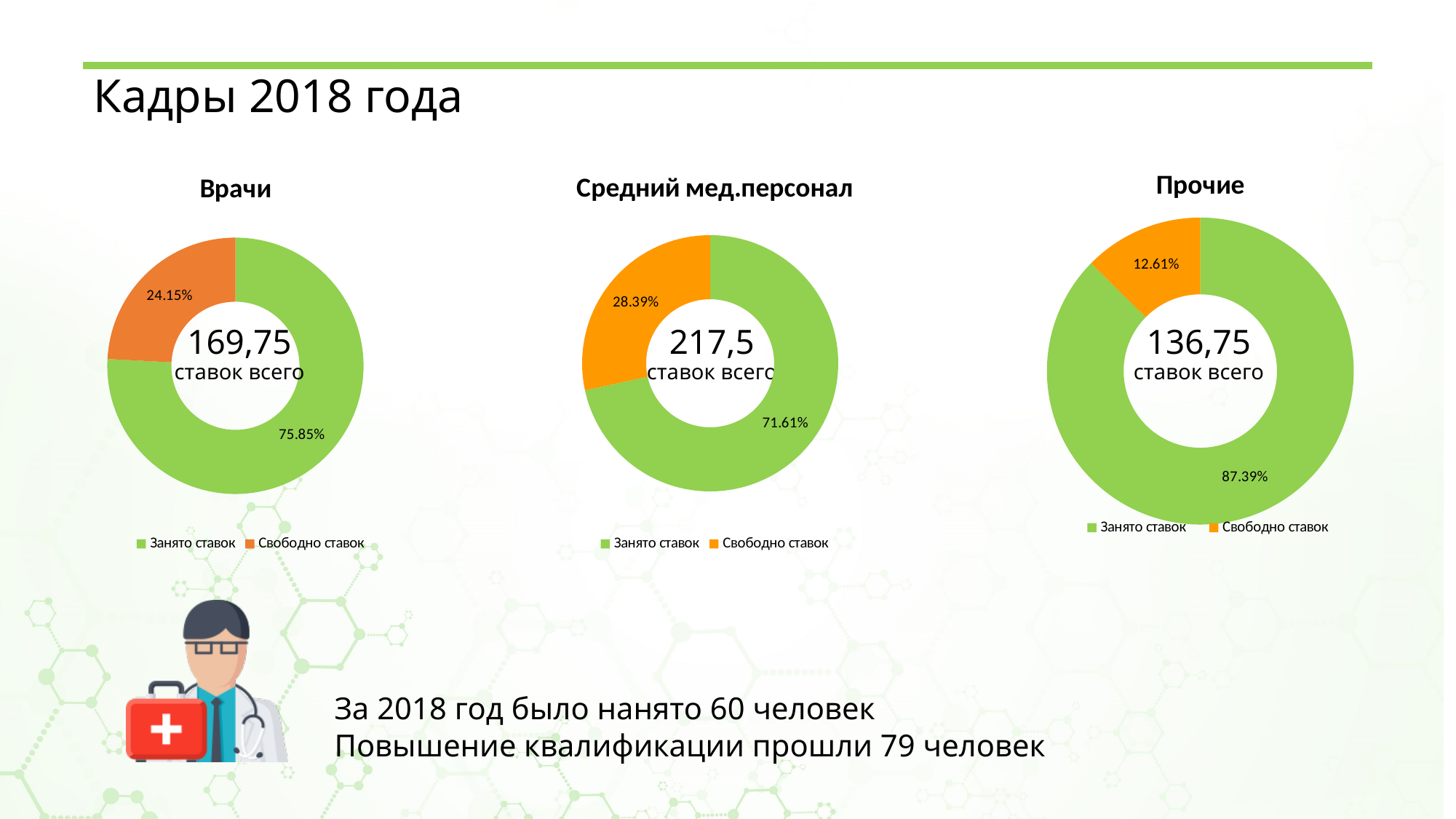
In the 'Врачи' chart, which slice is larger: 'Занято ставок' or 'Свободно ставок'? Занято ставок In the 'Врачи' chart, what percentage of positions is shown for 'Занято ставок'? 75.85% In the 'Средний мед.персонал' chart, what percentage is shown for 'Свободно ставок'? 28.39% In the 'Прочие' chart, what percentage is shown for 'Свободно ставок'? 12.61% How many entries does the legend of the 'Прочие' chart list? 2 What total number of positions ('ставок всего') is shown in the centre of the 'Прочие' chart? 136,75 In the 'Средний мед.персонал' chart, what is the difference in percentage points between 'Занято ставок' and 'Свободно ставок'? 43.22 In the 'Прочие' chart, what percentage is shown for 'Занято ставок'? 87.39% What type of chart is used for 'Врачи', 'Средний мед.персонал' and 'Прочие'? Pie (donut) chart In the 'Средний мед.персонал' chart, what percentage is shown for 'Занято ставок'? 71.61% What total number of positions ('ставок всего') is shown in the centre of the 'Средний мед.персонал' chart? 217,5 In the 'Врачи' chart, what percentage is shown for 'Свободно ставок'? 24.15%